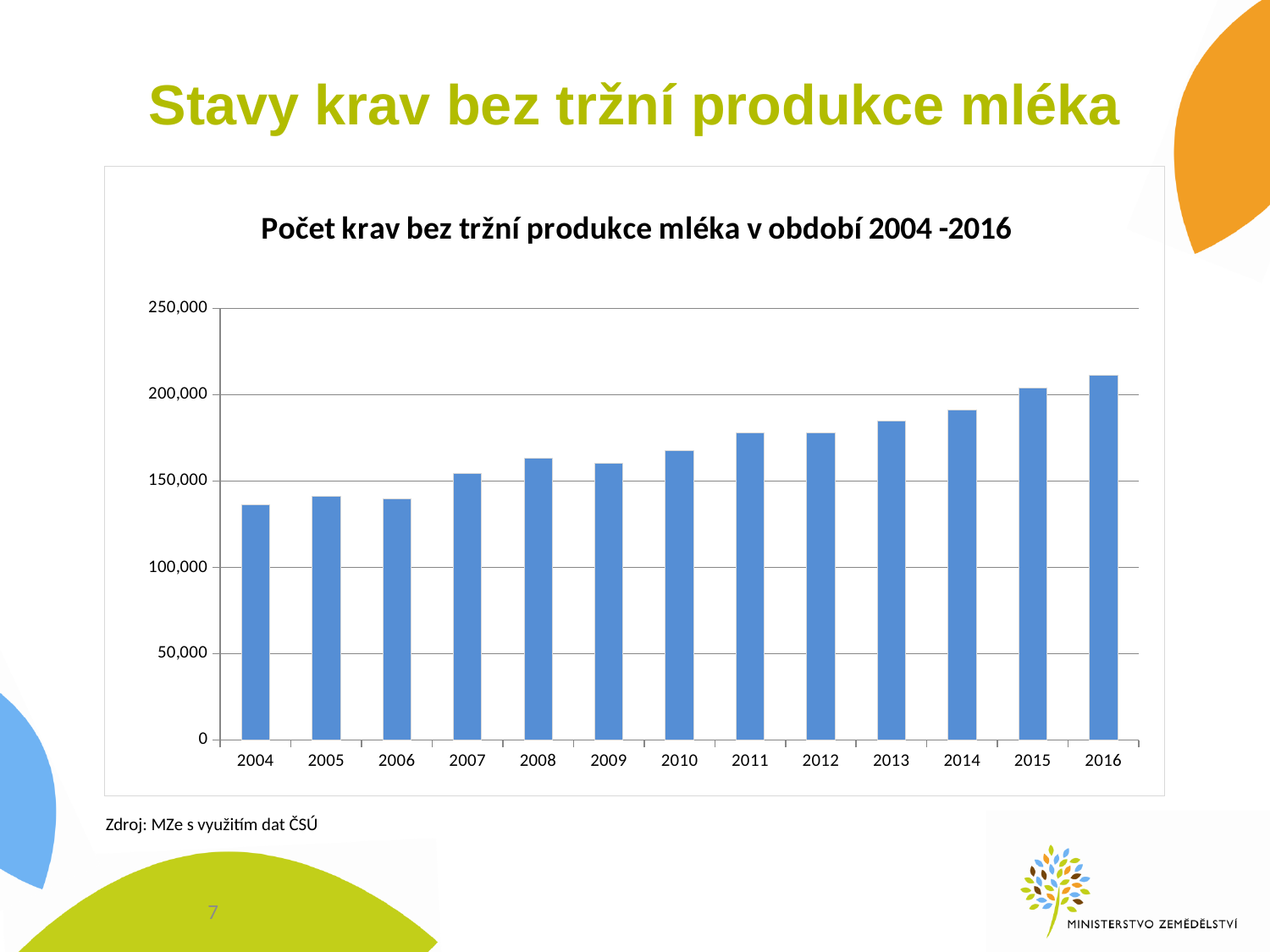
What is the highest value shown on the y axis of the chart? 250,000 Which is larger, the value for 2013 or the value for 2008? 2013 Which year has the highest value in the chart? 2016 Is the value for 2004 greater or less than 150,000? less What kind of chart is shown on the slide? bar chart Which is larger, the value for 2005 or the value for 2015? 2015 Is the value for 2016 greater or less than 200,000? greater What is the title of the chart? Počet krav bez tržní produkce mléka v období 2004 -2016 Do the values generally rise or fall from 2004 to 2016? rise Is the value for 2010 greater or less than 150,000? greater How many years are shown on the x axis of the chart? 13